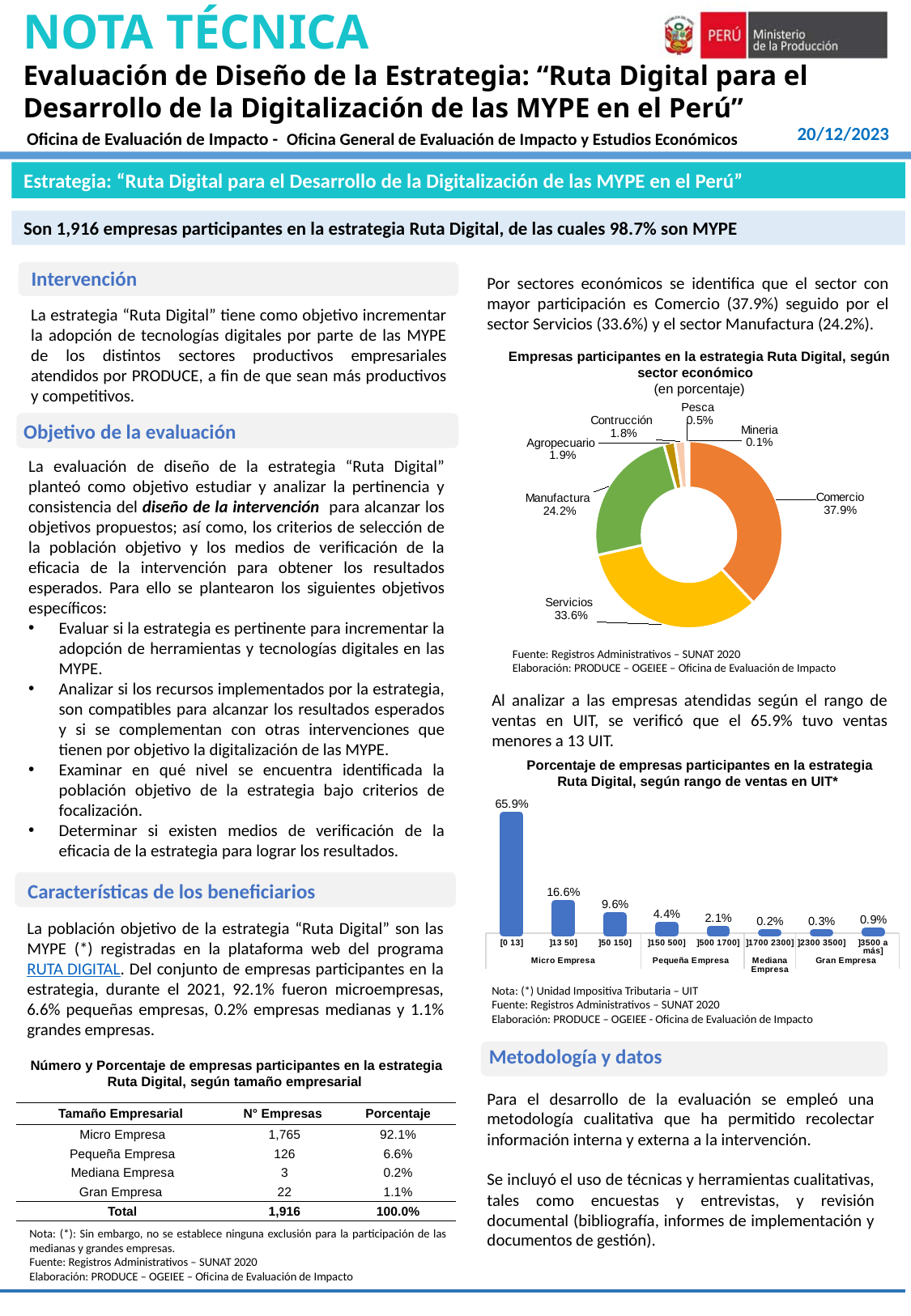
In the bar chart on rango de ventas en UIT, which range has the lowest value? ]1700 2300] In the bar chart on rango de ventas en UIT, which is larger: the value for ]13 50] or the value for ]50 150]? ]13 50] In the bar chart on rango de ventas en UIT, what is the value for the [0 13] range? 65.9% In the doughnut chart on sector económico, what is the difference between Comercio and Servicios? 4.3% In the bar chart on rango de ventas en UIT, how many bars are plotted? 8 In the doughnut chart on sector económico, which sector has the largest share? Comercio How many sectors are shown in the doughnut chart on sector económico? 7 What type of chart is the chart titled 'Empresas participantes en la estrategia Ruta Digital, según sector económico'? Doughnut chart In the doughnut chart on sector económico, which sector has the smallest share? Mineria In the bar chart on rango de ventas en UIT, what is the value for the ]500 1700] range? 2.1% In the doughnut chart on sector económico, what is the value for Comercio? 37.9% In the doughnut chart on sector económico, what is the value for Manufactura? 24.2%